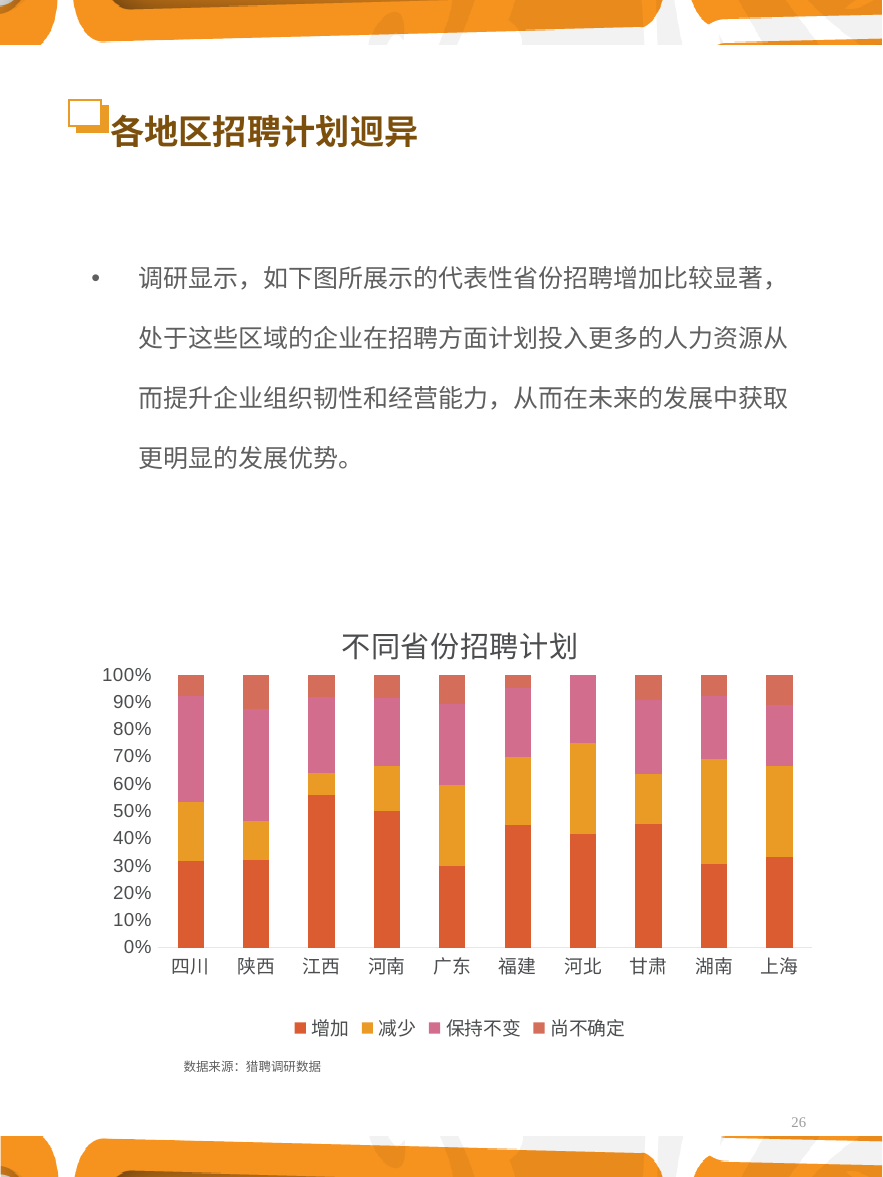
Is the 减少 share for 陕西 greater or less than 20%? less How many series does the chart legend list? 4 Which province has the largest 增加 share in the chart? 江西 Is the 增加 share for 广东 greater or less than 40%? less How many provinces are shown on the x axis of the chart? 10 Which province has the larger 增加 share, 江西 or 四川? 江西 Is the 增加 share for 江西 greater or less than 50%? greater What is the title of the chart? 不同省份招聘计划 What is the total of each stacked bar in the chart? 100% What kind of chart is shown on the slide? Stacked bar chart